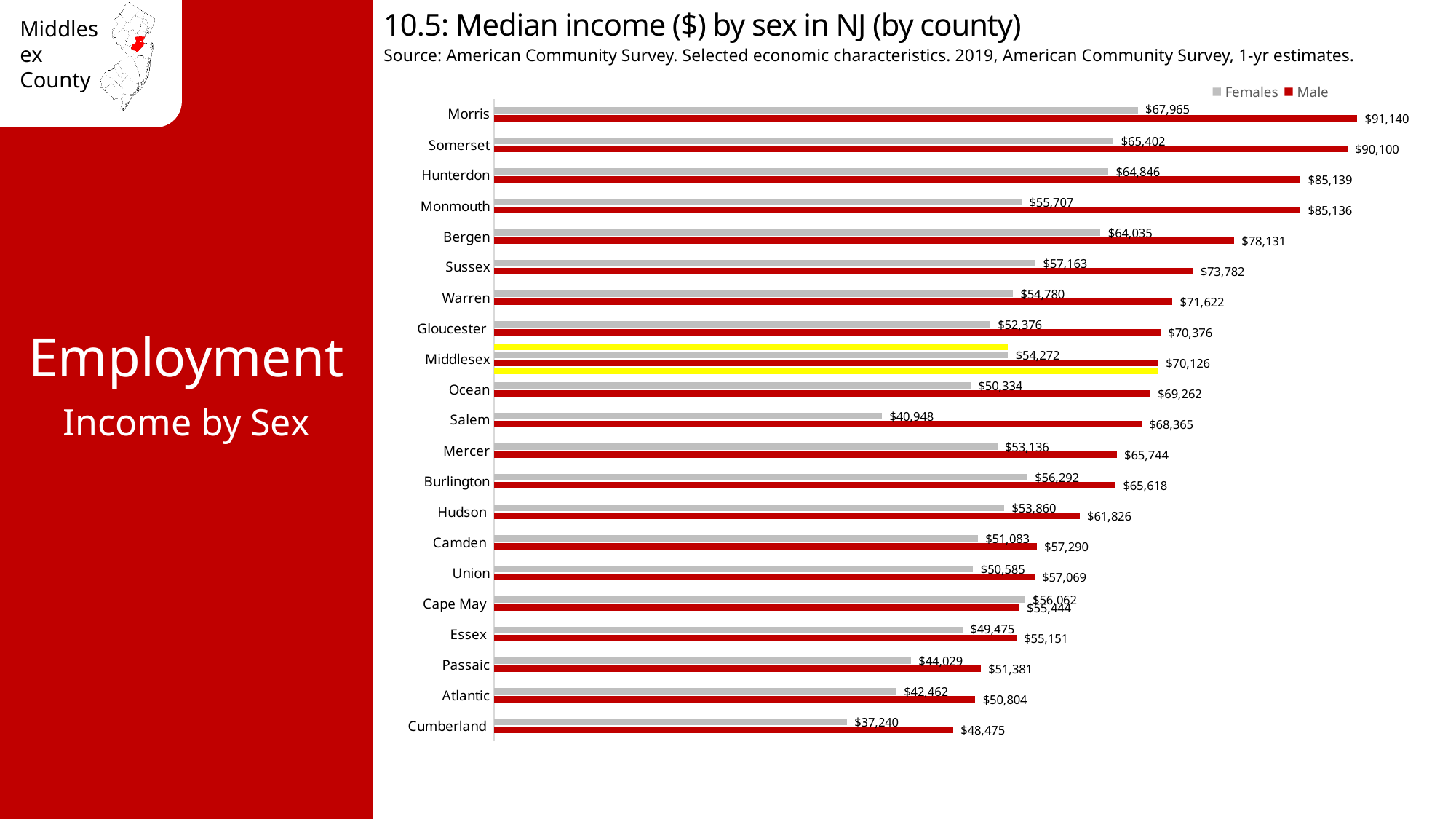
Which county has the lowest median income for females? Cumberland What is the difference between male and female median income in Morris County? $23,175 In Cape May County, is the median income higher for females or males? Females How many series does the legend list? 2 Which county has the highest median income for males? Morris What is the difference between male and female median income in Middlesex County? $15,854 How many counties are shown in the chart? 21 Which county's bars are highlighted in yellow on the chart? Middlesex What type of chart is shown on the slide? Bar chart What is the median income for males in Middlesex County? $70,126 Which is larger: the male median income in Hunterdon or in Monmouth? Hunterdon What is the median income for females in Salem County? $40,948